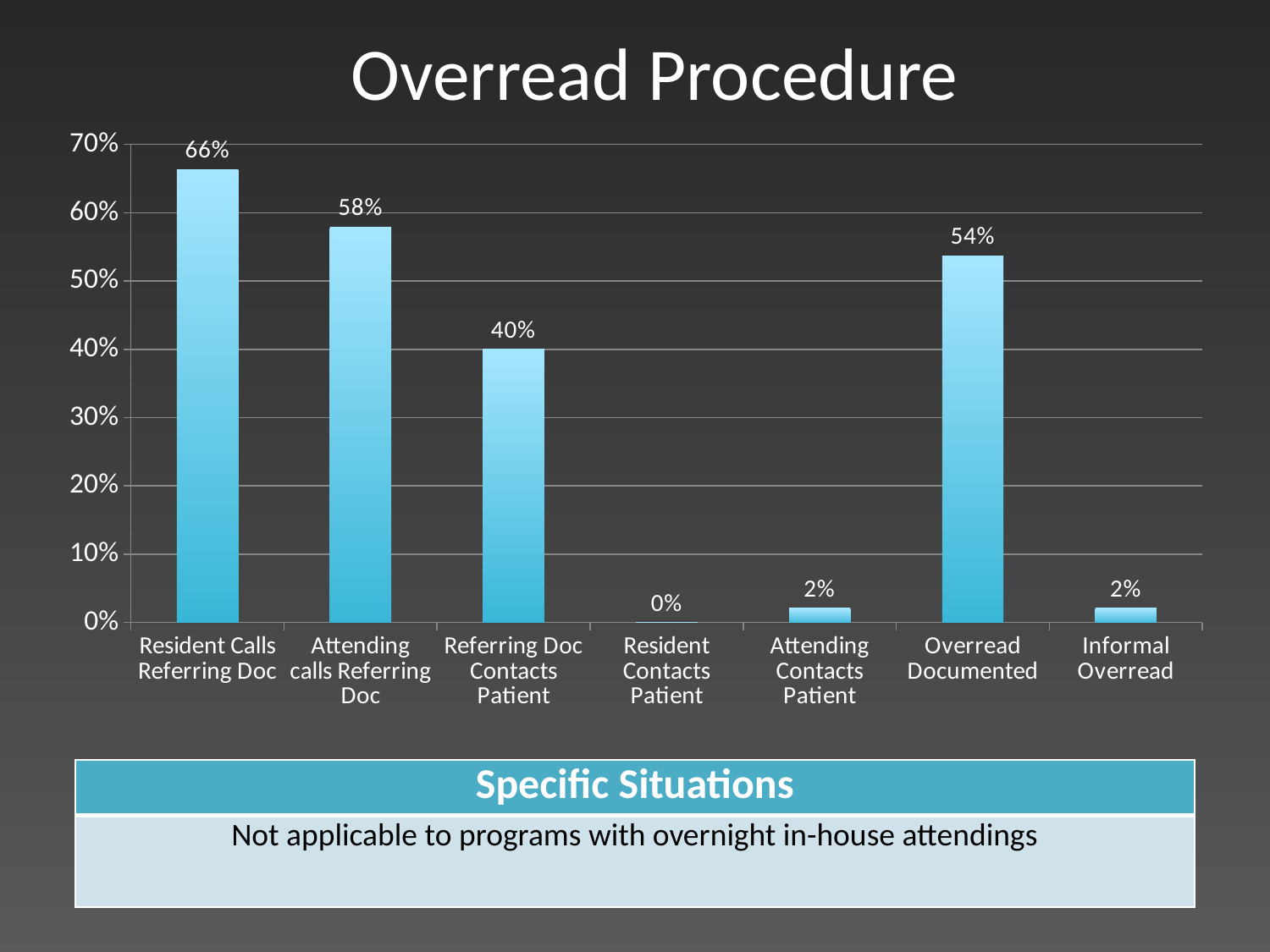
What is the value for Overread Documented? 54% What is the value for Resident Calls Referring Doc? 66% Which is larger, Attending calls Referring Doc or Overread Documented? Attending calls Referring Doc What is the difference between Resident Calls Referring Doc and Attending calls Referring Doc? 8% What is the difference between Overread Documented and Referring Doc Contacts Patient? 14% What is the value for Referring Doc Contacts Patient? 40% What is the title of the chart? Overread Procedure What kind of chart is shown on the slide? Bar chart How many categories are shown on the x axis? 7 Which category has the lowest value? Resident Contacts Patient What is the value for Resident Contacts Patient? 0% Which category has the highest value? Resident Calls Referring Doc